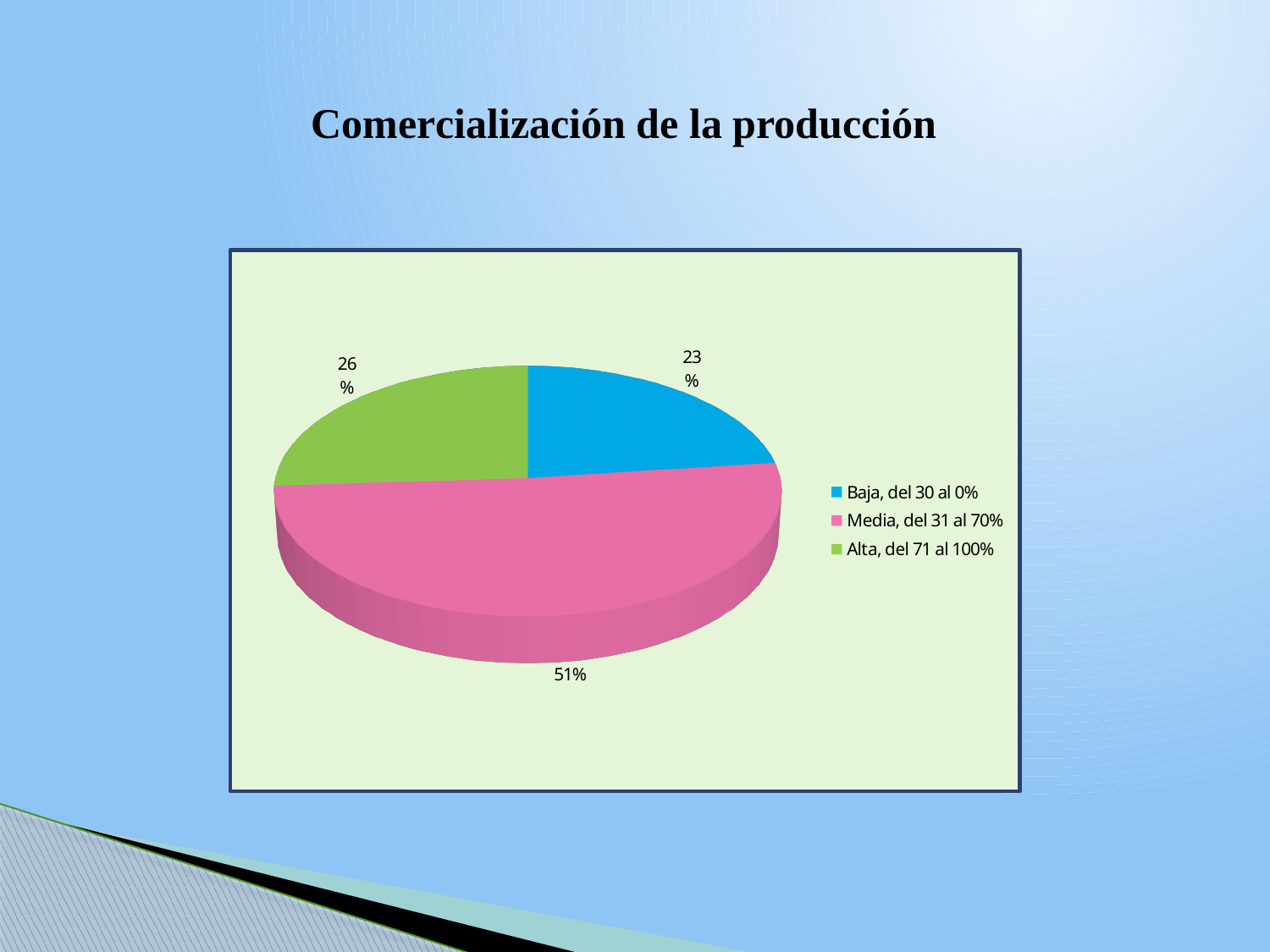
What share of the pie does "Baja, del 30 al 0%" have? 23% What colour is the slice for "Media, del 31 al 70%"? pink What share of the pie does "Alta, del 71 al 100%" have? 26% Which category has the smallest slice of the pie? Baja, del 30 al 0% Which slice is larger, Alta or Baja? Alta What is the title of the slide above the chart? Comercialización de la producción What is the difference in percentage points between the Media slice and the Alta slice? 25 How many categories does the pie chart show? 3 What kind of chart is shown on the slide? pie chart Which category has the largest slice of the pie? Media, del 31 al 70% What share of the pie does "Media, del 31 al 70%" have? 51%